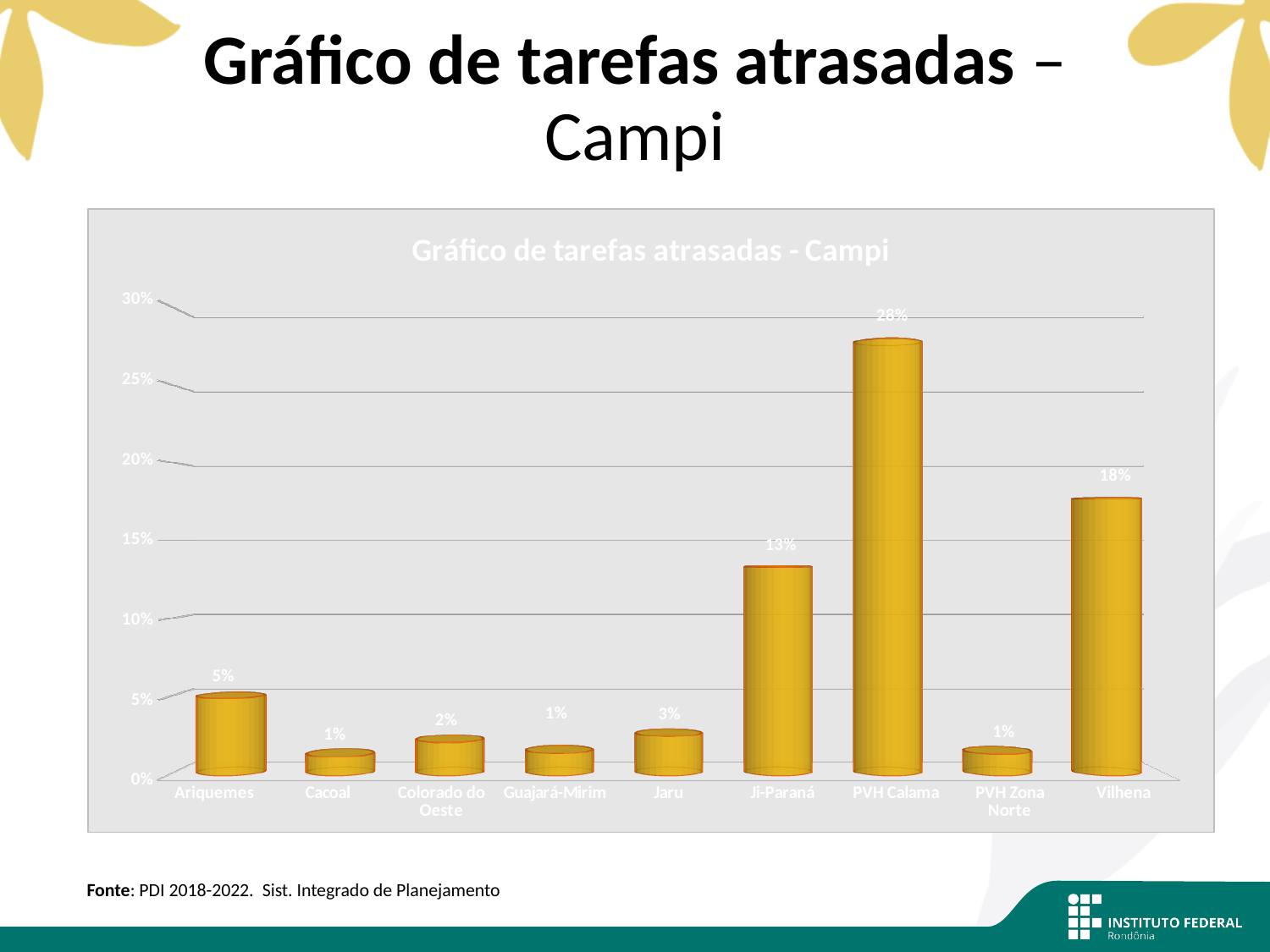
What is the title of the chart? Gráfico de tarefas atrasadas - Campi What is the value for Ariquemes? 5% What kind of chart is shown? Bar chart Which campus has the highest value? PVH Calama Which is larger, the value for Vilhena or the value for Ji-Paraná? Vilhena How many campi are shown on the x axis? 9 What is the difference between the values for PVH Calama and Vilhena? 10% What is the value for PVH Calama? 28% What is the difference between the values for Ji-Paraná and Ariquemes? 8% What is the value for Vilhena? 18% What is the value for Jaru? 3% What is the value for Ji-Paraná? 13%